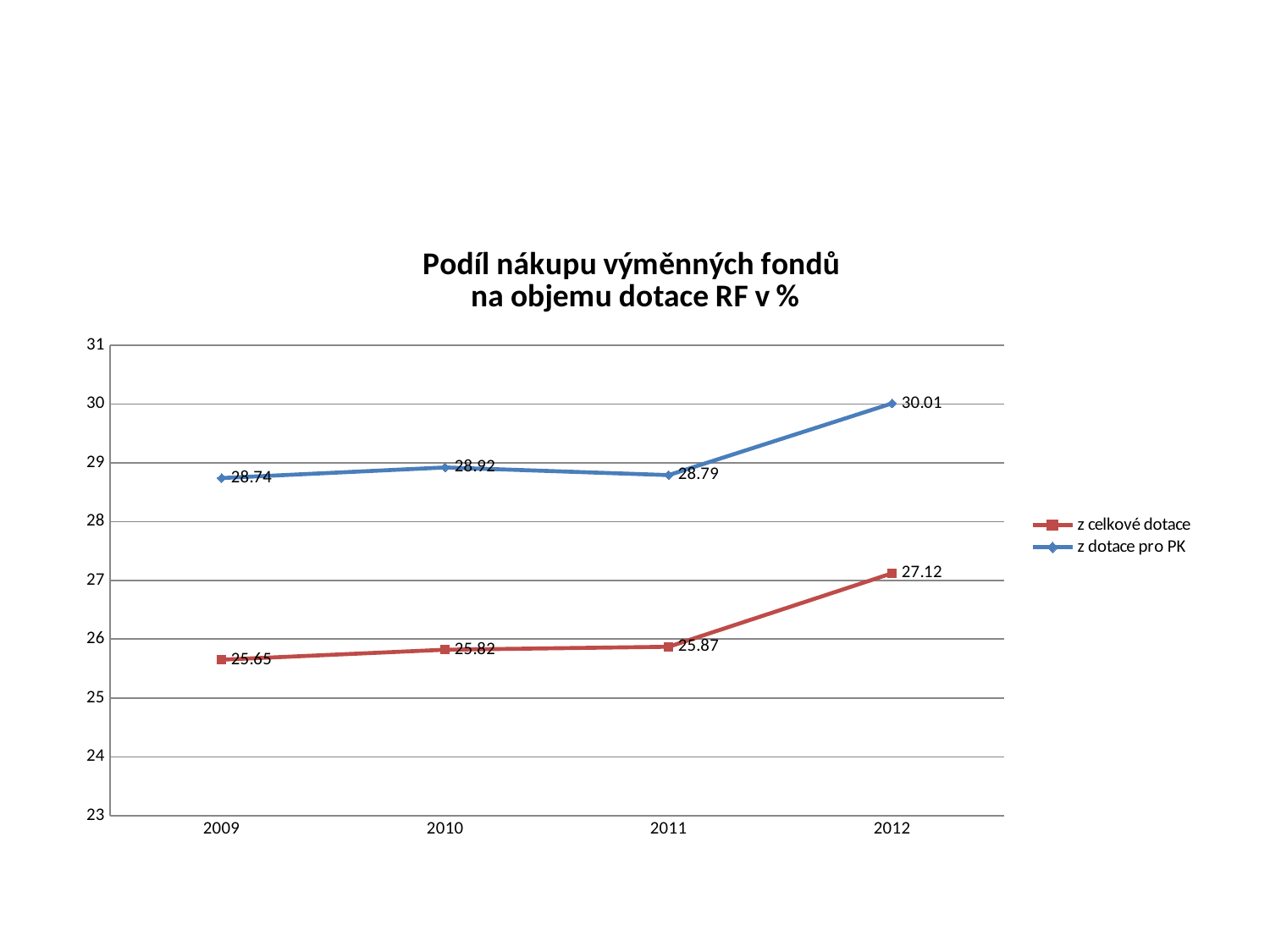
In which year is the value for 'z dotace pro PK' lowest? 2009 How many series does the legend list? 2 What is the value for 'z dotace pro PK' in 2012? 30.01 Which series has the larger value in 2011, 'z celkové dotace' or 'z dotace pro PK'? z dotace pro PK In which year is the value for 'z celkové dotace' highest? 2012 Is the value for 'z celkové dotace' in 2012 greater or less than 27? greater What kind of chart is shown on the slide? line chart What is the difference between the 'z dotace pro PK' and 'z celkové dotace' values in 2012? 2.89 What is the value for 'z dotace pro PK' in 2010? 28.92 What is the value for 'z celkové dotace' in 2011? 25.87 What is the value for 'z celkové dotace' in 2009? 25.65 How many years are shown on the x axis? 4